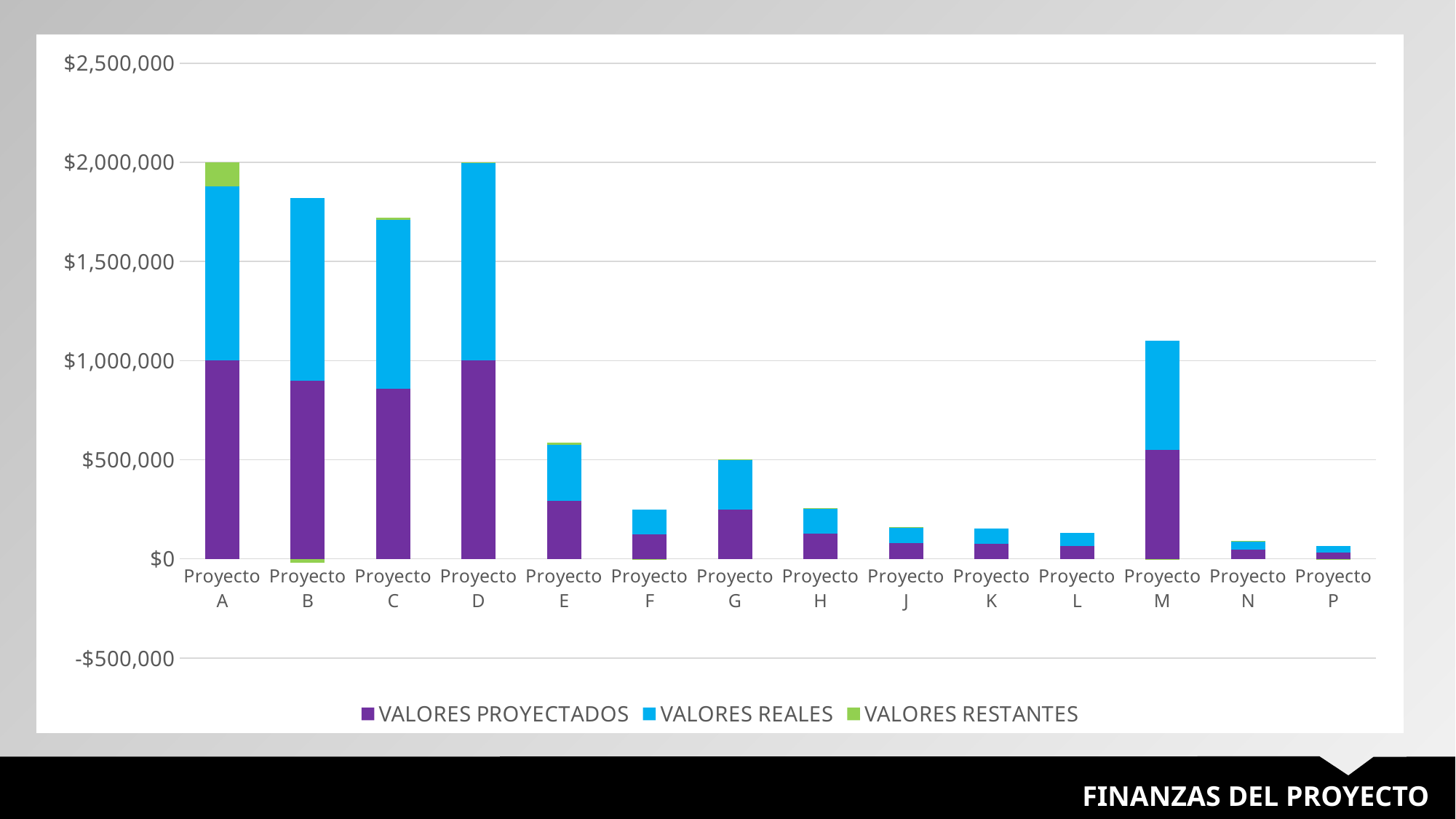
Which colour represents VALORES REALES in the chart? Blue Is the total value for Proyecto F greater or less than $500,000? less How many projects (categories) are shown on the x axis? 14 Is the total value for Proyecto M greater or less than $1,000,000? greater What are the three series listed in the legend? VALORES PROYECTADOS, VALORES REALES, VALORES RESTANTES What is the total height of the stacked bar for Proyecto D? $2,000,000 What is the VALORES PROYECTADOS value for Proyecto A? $1,000,000 Which has the larger total bar, Proyecto M or Proyecto G? Proyecto M What kind of chart is shown on the slide? Stacked bar chart Is the total value for Proyecto B greater or less than $1,500,000? greater How many series does the legend list? 3 Which has the larger total bar, Proyecto B or Proyecto C? Proyecto B